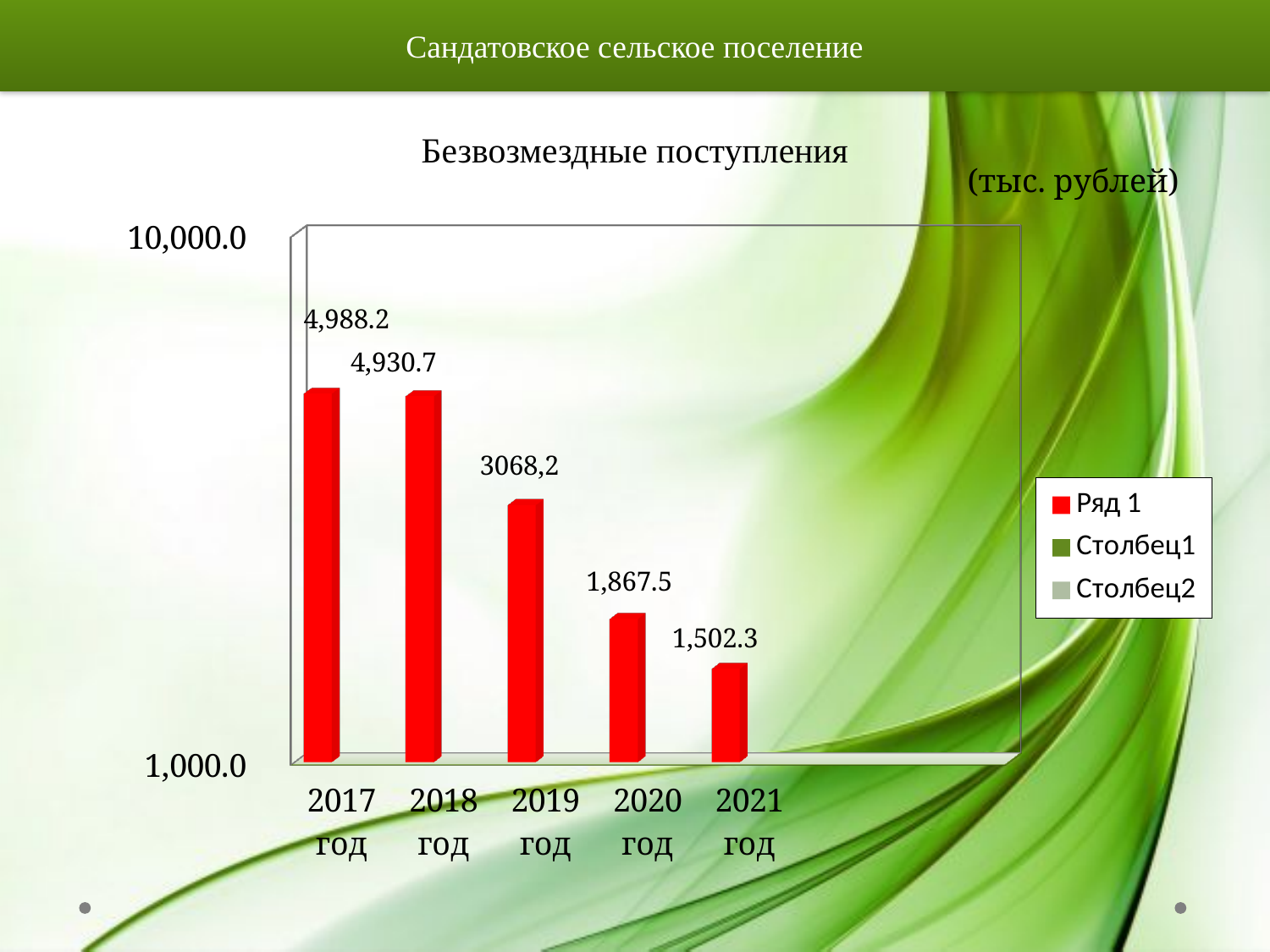
How many entries does the chart legend list? 3 Which year has the lowest value in the chart? 2021 год What is the difference between the values for 2020 год and 2021 год? 365.2 What is the value for 2017 год in the chart? 4,988.2 How many years are shown on the x axis of the chart? 5 What type of chart is shown on the slide? bar chart Do the values rise or fall from 2017 год to 2021 год? fall Which is larger, the value for 2019 год or the value for 2020 год? 2019 год What is the value for 2021 год in the chart? 1,502.3 Which year has the highest value in the chart? 2017 год What is the value for 2019 год in the chart? 3068,2 What is the value for 2020 год in the chart? 1,867.5